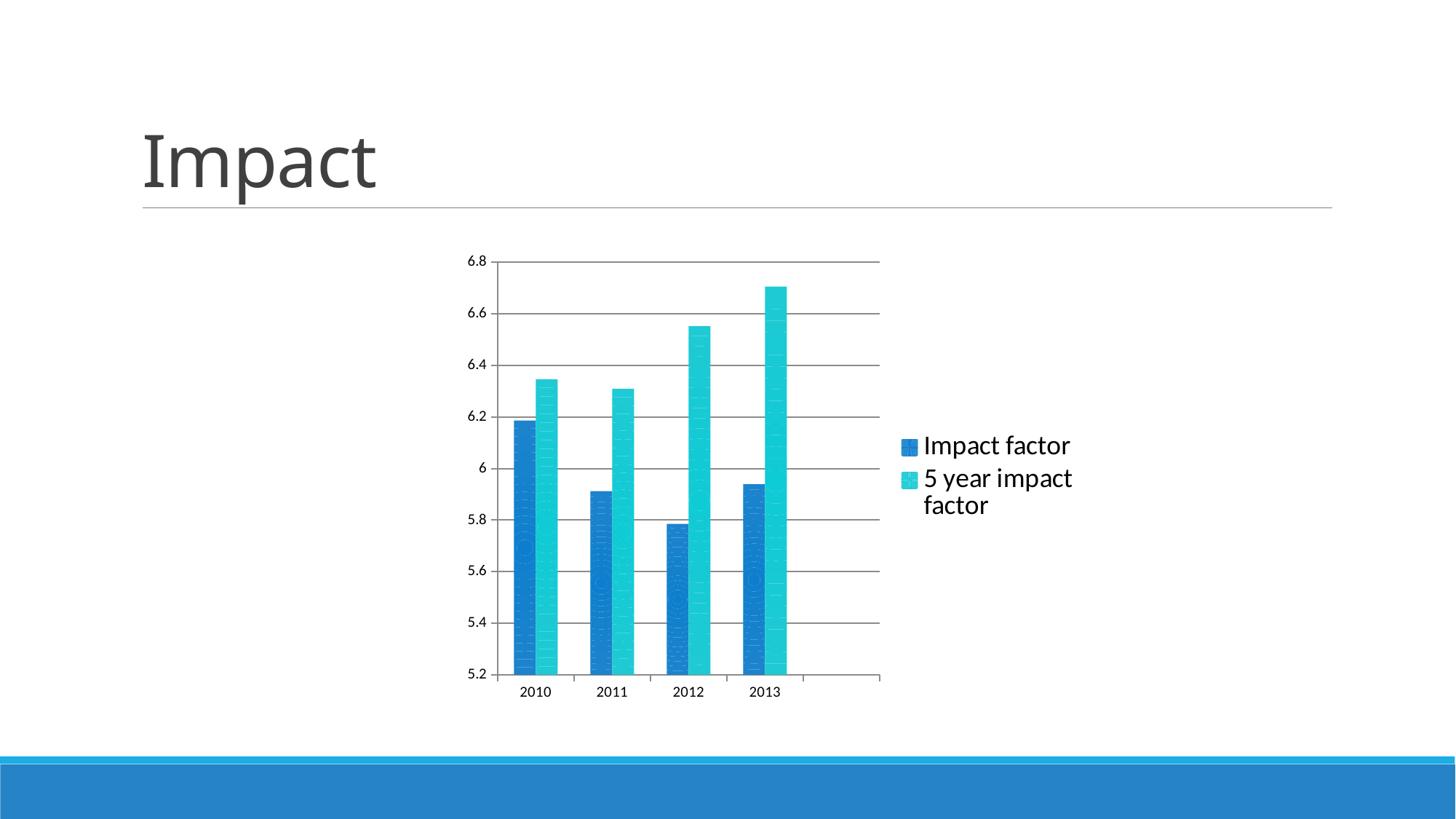
Which year has the highest 5 year impact factor? 2013 How many years are shown on the x axis? 4 How many series does the legend list? 2 Is the 5 year impact factor for 2013 greater or less than 6.6? greater Does the 5 year impact factor rise or fall from 2011 to 2013? Rise What kind of chart is shown on the slide? Bar chart Is the Impact factor for 2012 greater or less than 6? less What are the two series named in the legend? Impact factor and 5 year impact factor Which year has the lowest Impact factor? 2012 Is the Impact factor for 2010 greater or less than 6? greater Which is larger, the 5 year impact factor for 2010 or for 2013? 2013 Which year has the highest Impact factor? 2010